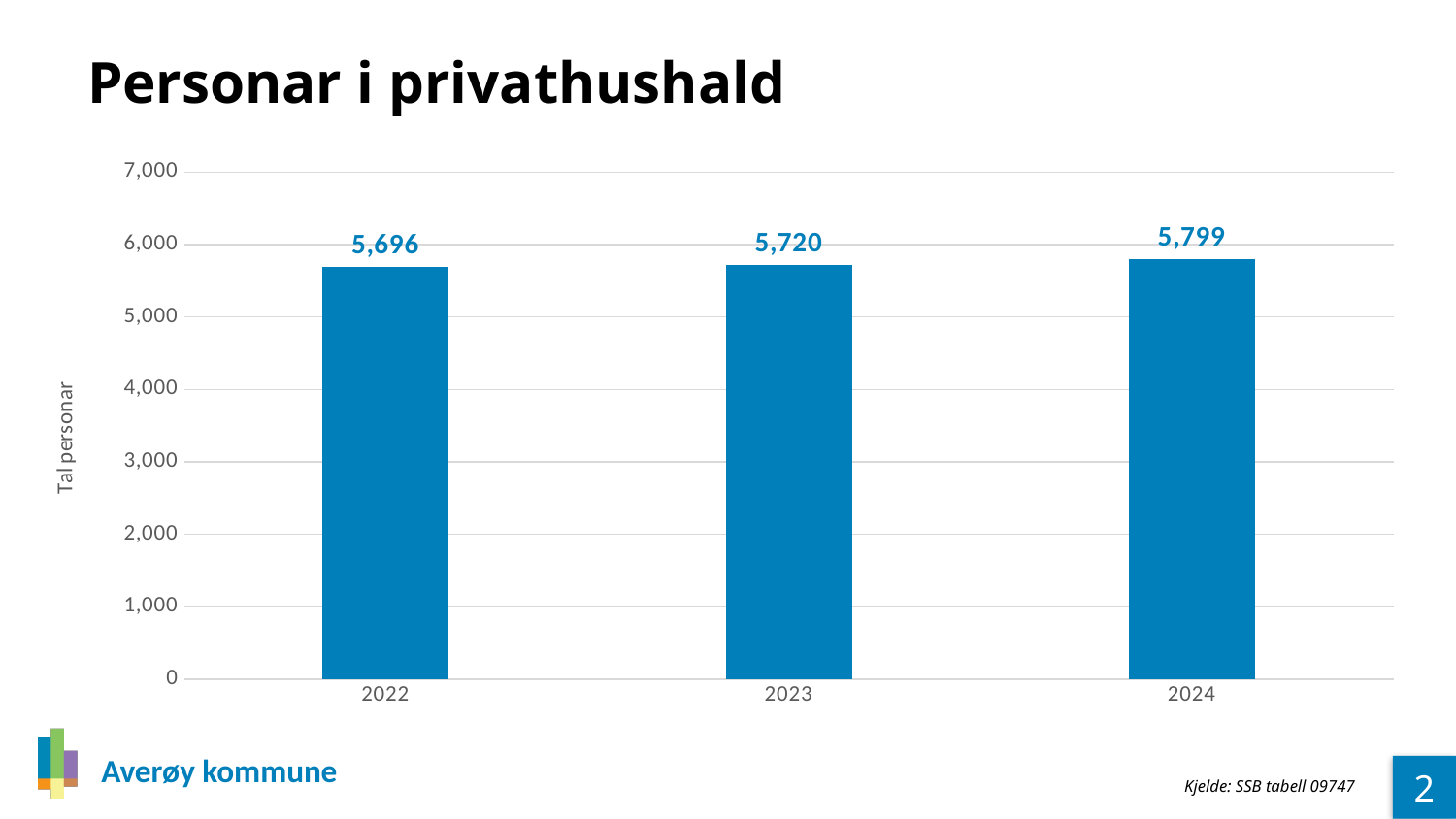
Do the values rise or fall from 2022 to 2024? rise What is the difference between the values for 2024 and 2022? 103 What is the difference between the values for 2023 and 2022? 24 Which is larger, the value for 2023 or the value for 2024? 2024 What is the value for 2023? 5,720 Which year has the lowest value? 2022 Is the value for 2024 greater or less than 6,000? less What is the value for 2024? 5,799 What kind of chart is shown? bar chart How many years are shown on the x axis? 3 Which year has the highest value? 2024 What is the value for 2022? 5,696